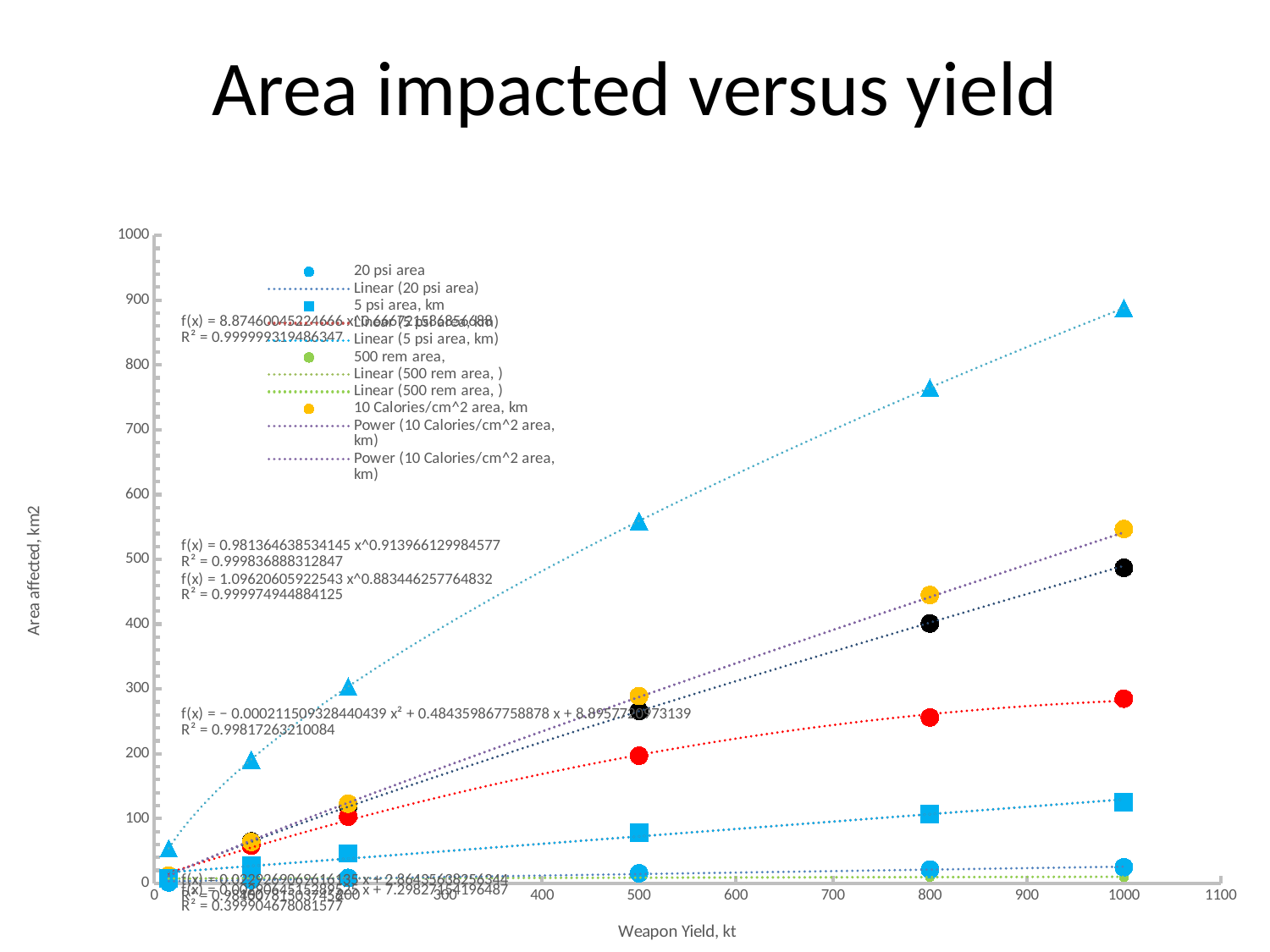
What is the label of the x axis? Weapon Yield, kt Does the area affected for the 5 psi area series rise or fall as weapon yield increases? rise Is the value for the 5 psi area series at 500 kt greater or less than 100? less Is the value for the 500 rem area series at 1000 kt greater or less than 100? less What kind of chart is shown on the slide? scatter chart What is the title of the chart? Area impacted versus yield Is the value for the 10 Calories/cm^2 area series at 800 kt greater or less than 400? greater At 1000 kt, which is larger: the 10 Calories/cm^2 area or the 5 psi area? 10 Calories/cm^2 area Does the area affected for the 10 Calories/cm^2 area series rise or fall as weapon yield increases? rise